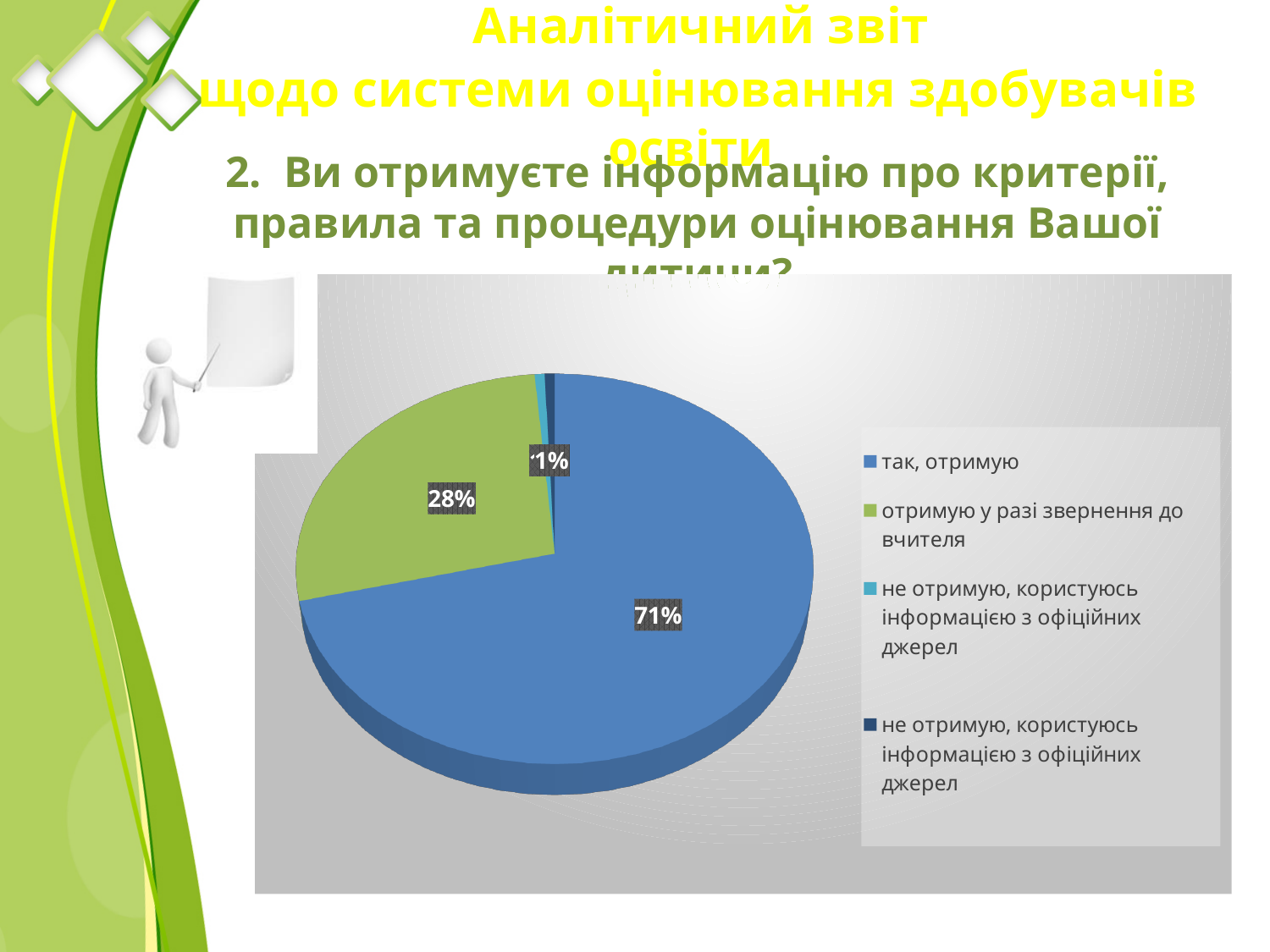
What kind of chart is shown on the slide? pie chart What colour is the "так, отримую" slice? blue What is the difference in percentage points between the "так, отримую" slice and the "отримую у разі звернення до вчителя" slice? 43 percentage points Which category has the largest slice of the pie? так, отримую Which slice is larger: "так, отримую" or "отримую у разі звернення до вчителя"? так, отримую What share of the pie does the "так, отримую" slice represent? 71% What colour is the "отримую у разі звернення до вчителя" slice? green What percentage of the pie is labelled for "так, отримую"? 71% What percentage of the pie is labelled for "отримую у разі звернення до вчителя"? 28% How many entries does the legend list? 4 Is the share for "отримую у разі звернення до вчителя" greater or less than 50%? less